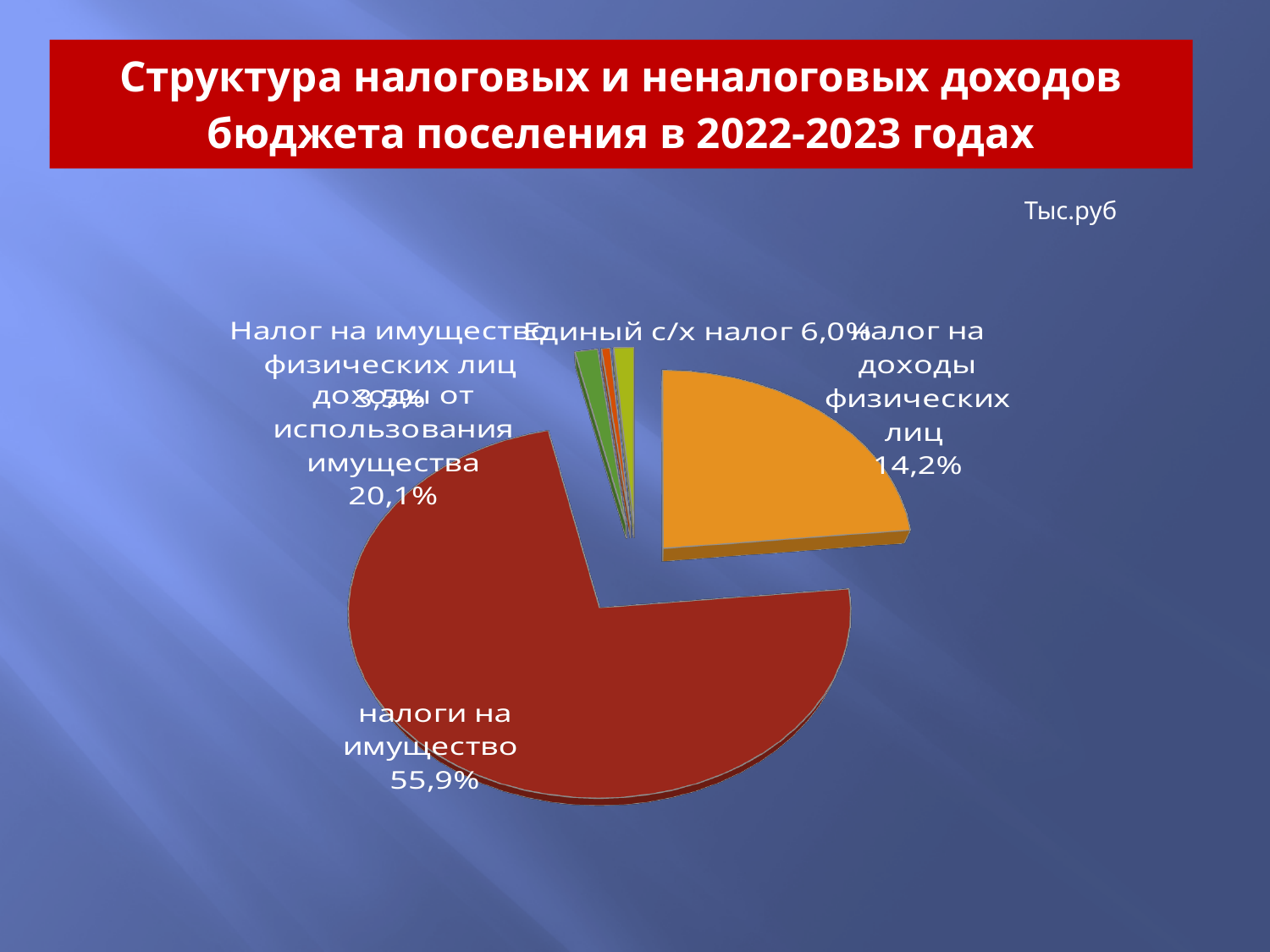
Which category has the largest slice of the pie? налоги на имущество What share is shown for "Налог на доходы физических лиц"? 14,2% What share of the pie is labelled "налоги на имущество"? 55,9% Which is larger: "Единый с/х налог" or "Налог на доходы физических лиц"? Налог на доходы физических лиц What share is shown for "Единый с/х налог"? 6,0% By how many percentage points does "налоги на имущество" exceed "Налог на доходы физических лиц"? 41,7% What share is shown for "доходы от использования имущества"? 20,1% By how many percentage points does "доходы от использования имущества" exceed "Единый с/х налог"? 14,1% What unit is indicated in the top right corner above the chart? Тыс.руб What kind of chart is shown on the slide? pie chart What is the title of the slide containing the chart? Структура налоговых и неналоговых доходов бюджета поселения в 2022-2023 годах